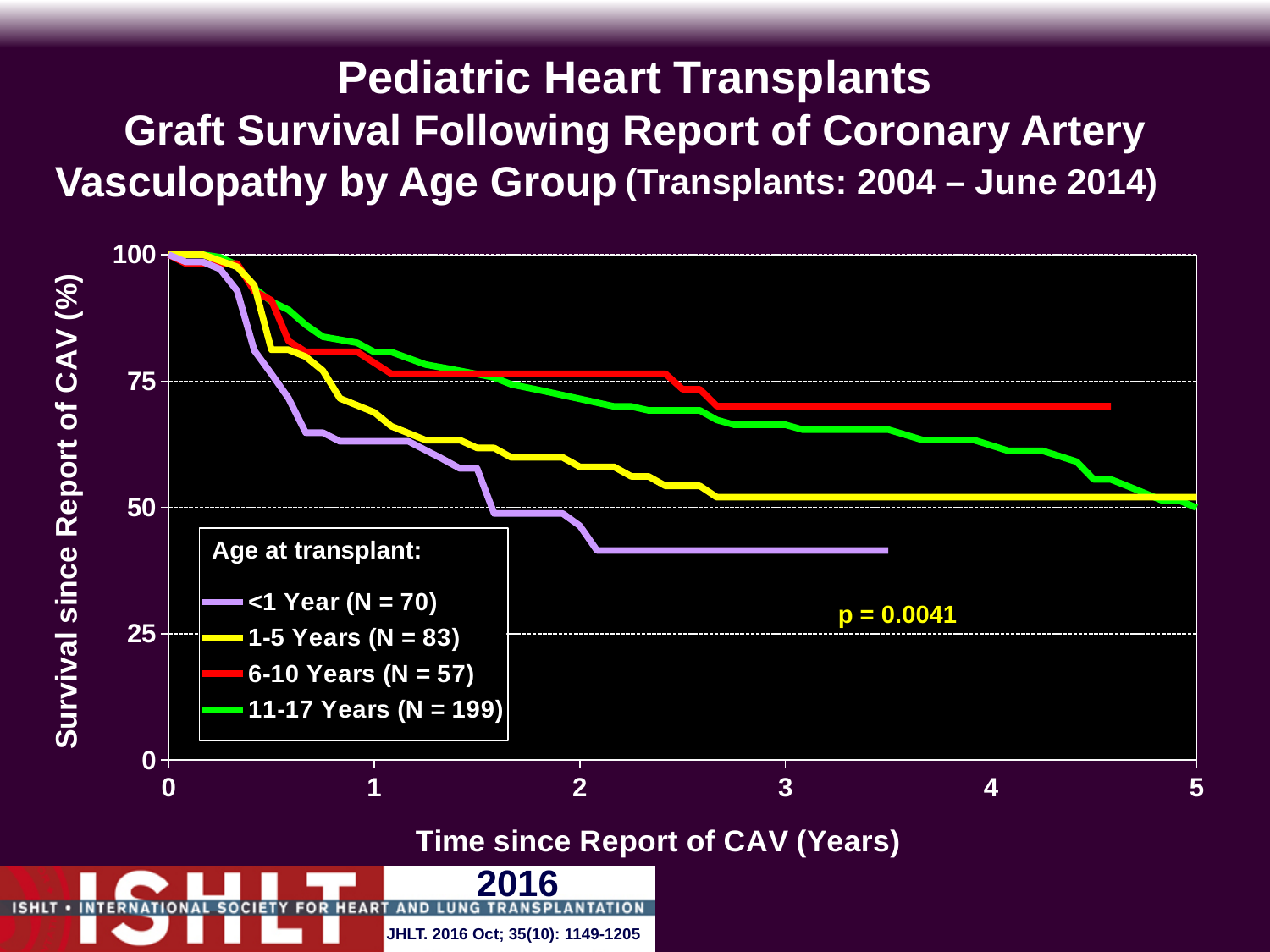
Do the survival curves rise or fall as time since report of CAV increases? fall Is the survival value for the 1-5 Years group at 4 years greater or less than 75? less At 2 years since report of CAV, which group has higher survival: 1-5 Years or 11-17 Years? 11-17 Years At 3 years since report of CAV, which group has higher survival: 6-10 Years or <1 Year? 6-10 Years Is the survival value for the 6-10 Years group at 4 years greater or less than 75? less What is the N for the 11-17 Years group shown in the legend? 199 Is the survival value for the 11-17 Years group at 3 years greater or less than 50? greater How many age groups does the legend list? 4 Which age group has the highest survival at 4 years since report of CAV? 6-10 Years Which age group has the lowest survival at 3 years since report of CAV? <1 Year What kind of chart is shown on the slide? line chart